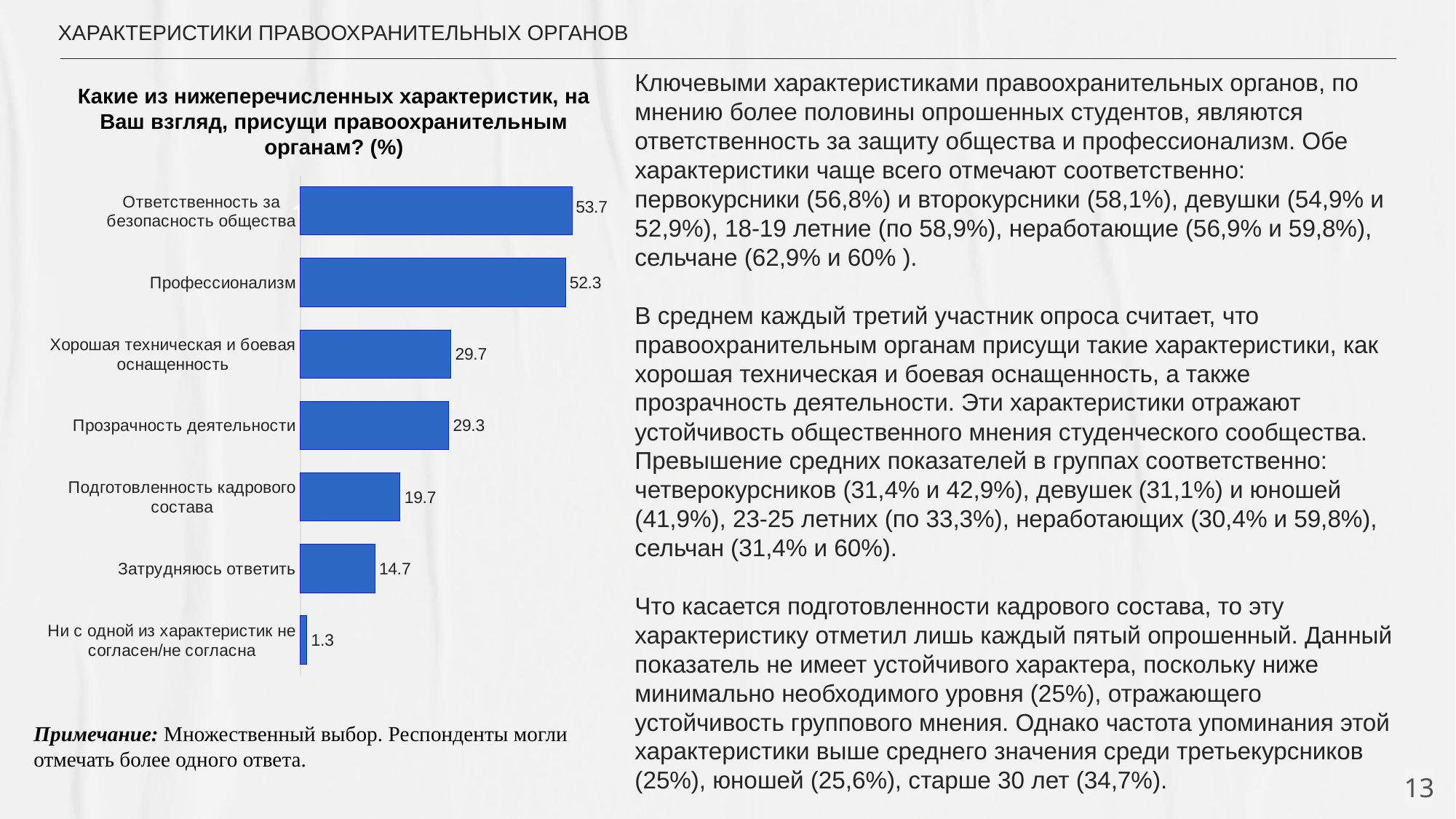
What is the difference between the values for «Ответственность за безопасность общества» and «Профессионализм»? 1.4 Which category has the lowest value? Ни с одной из характеристик не согласен/не согласна What value is shown for «Затрудняюсь ответить»? 14.7 How many categories are shown in the chart? 7 What value is shown for «Профессионализм»? 52.3 What is the difference between the values for «Подготовленность кадрового состава» and «Затрудняюсь ответить»? 5.0 Which category has the highest value? Ответственность за безопасность общества What is the title of the chart? Какие из нижеперечисленных характеристик, на Ваш взгляд, присущи правоохранительным органам? (%) What kind of chart is shown on the slide? Bar chart What value is shown for «Ответственность за безопасность общества»? 53.7 What value is shown for «Прозрачность деятельности»? 29.3 Which is larger: the value for «Хорошая техническая и боевая оснащенность» or for «Подготовленность кадрового состава»? Хорошая техническая и боевая оснащенность